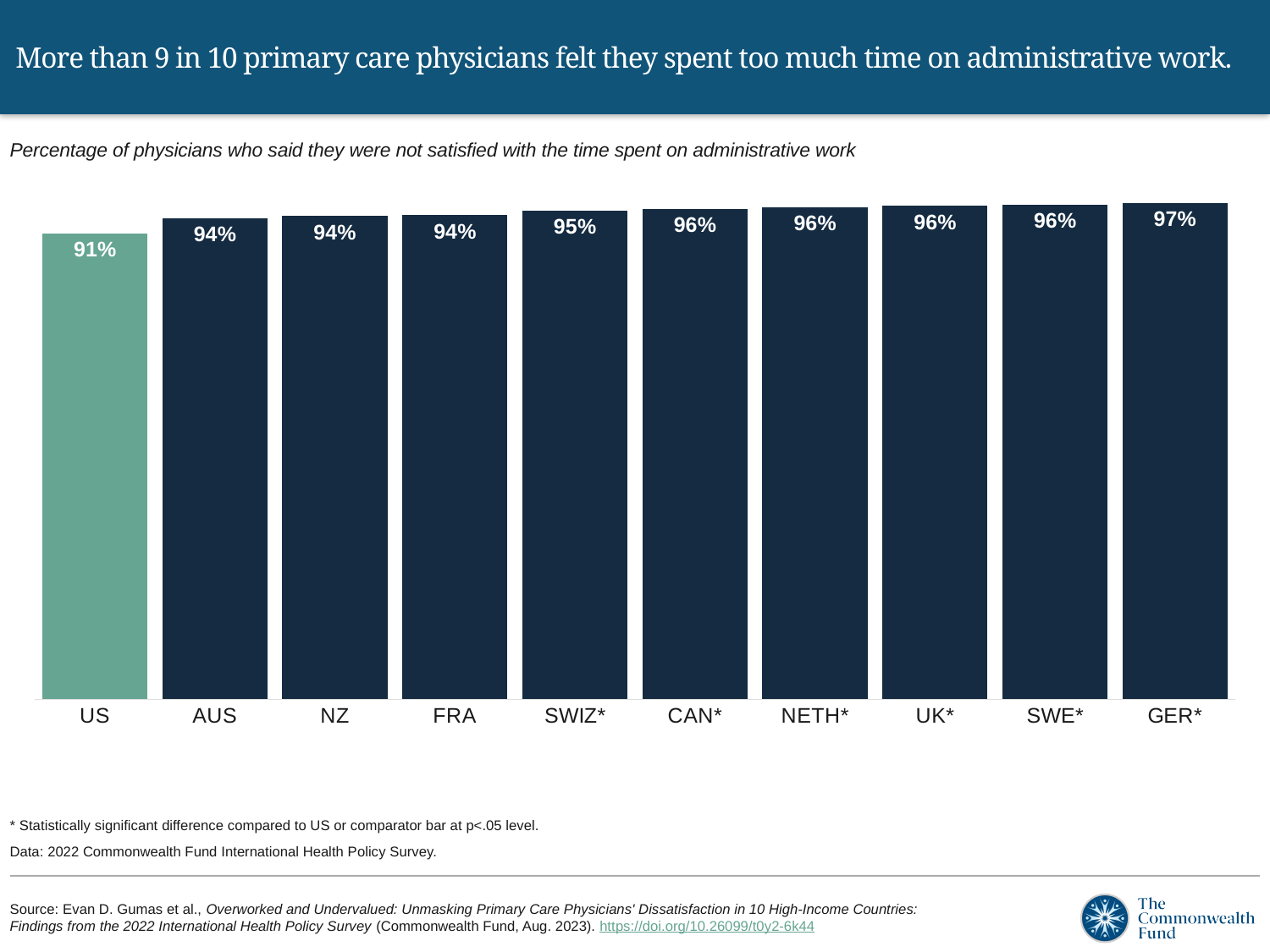
Which bar is shown in a different colour (green) from the others? US What is the difference in percentage points between GER* and the US? 6 How many countries are shown in the chart? 10 Which country has the lowest percentage of physicians not satisfied with time spent on administrative work? US Which country has the highest percentage of physicians not satisfied with time spent on administrative work? GER* What is the value shown for FRA? 94% What percentage of physicians in the US said they were not satisfied with the time spent on administrative work? 91% Which has a higher value, US or SWIZ*? SWIZ* What is the value shown for GER*? 97% What type of chart is shown on the slide? Bar chart What is the value shown for SWIZ*? 95% What is the difference in percentage points between AUS and the US? 3